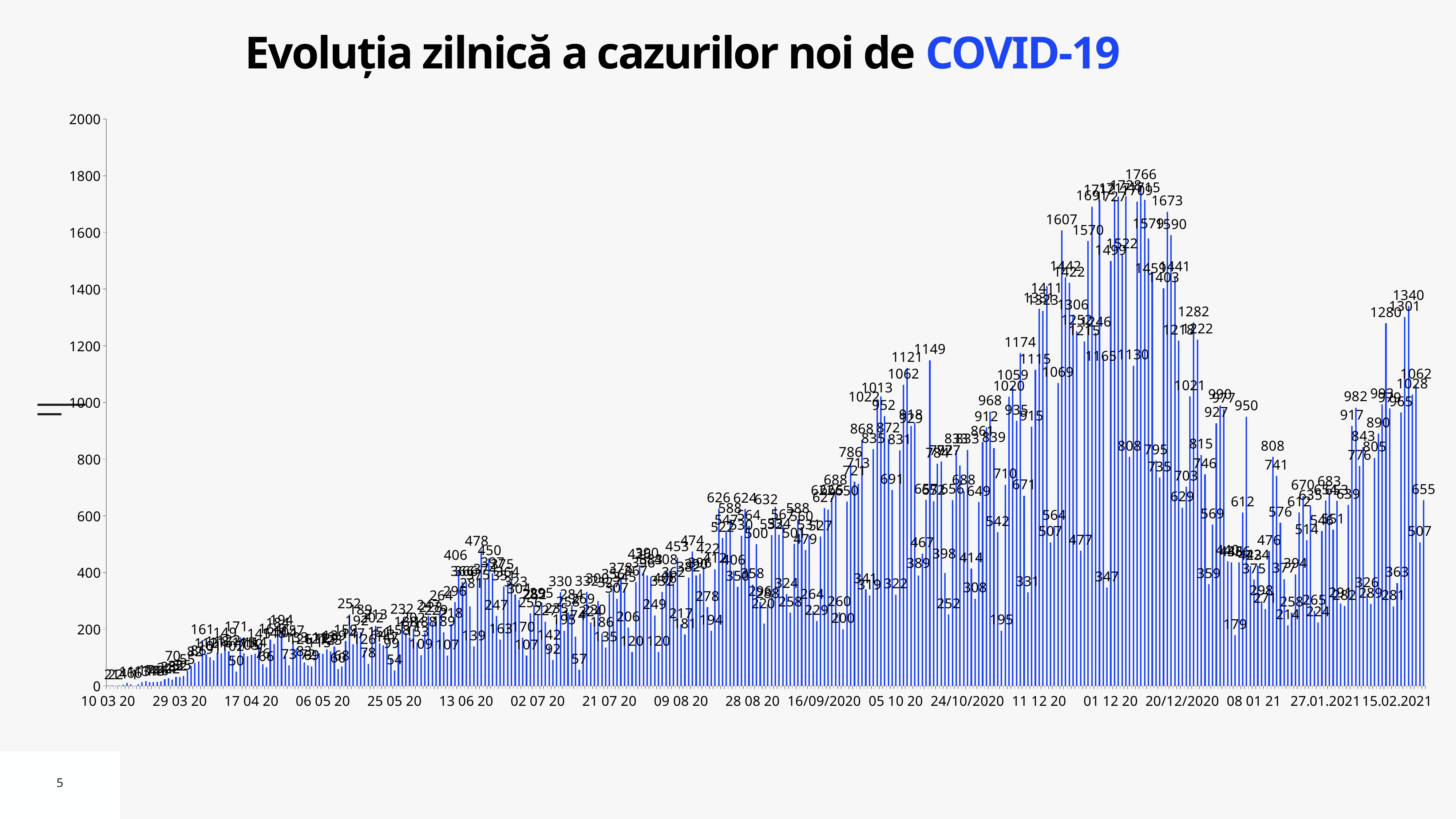
What is the first date label on the horizontal axis? 10 03 20 Is the highest value on the chart greater or less than 1800? less What is the last date label on the horizontal axis? 15.02.2021 What is the title of the chart? Evoluția zilnică a cazurilor noi de COVID-19 What kind of chart is shown on the slide? bar chart What is the maximum value shown on the vertical axis? 2000 Do the daily values generally rise or fall from 10 03 20 to 01 12 20? rise Is the tallest bar greater or less than 1600? greater What is the highest daily value labeled on the chart? 1766 How many data series are plotted on the chart? 1 What is the difference between the bar labeled 1766 and the bar labeled 1673? 93